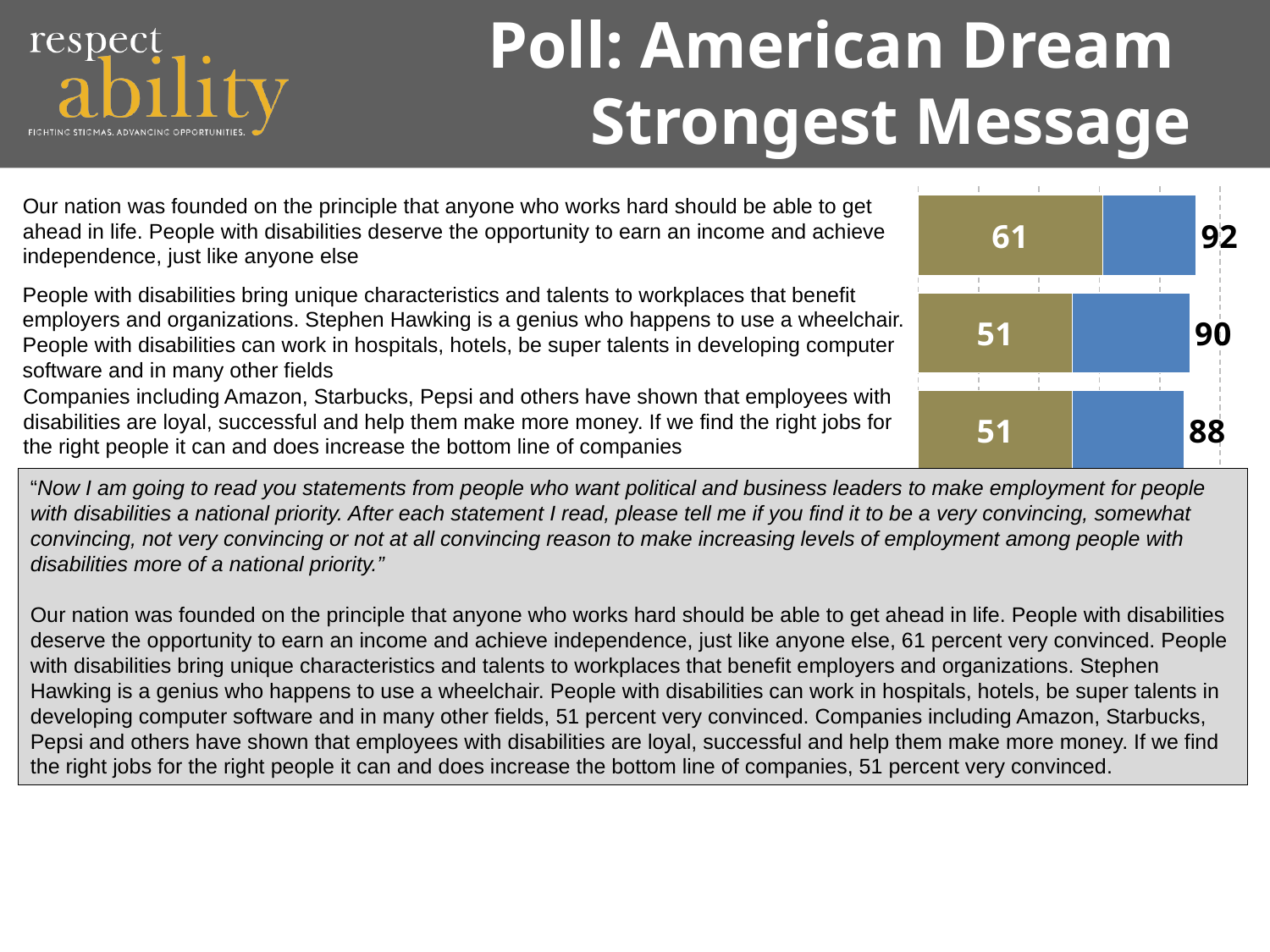
What value is printed in the olive segment of the middle bar (the Stephen Hawking statement)? 51 What value is printed in the olive segment of the top bar (the statement about the nation being founded on the principle that anyone who works hard should get ahead)? 61 What number is printed at the right end of the bottom bar (the Amazon, Starbucks, Pepsi statement)? 88 What number is printed at the right end of the top bar? 92 How many bars does the chart on the right contain? 3 Which bar has the highest value printed in its olive segment? The top bar (nation founded on the principle that anyone who works hard should get ahead) What type of chart is shown on the right side of the slide? Bar chart Do the numbers printed at the right ends of the bars increase or decrease from the top bar to the bottom bar? Decrease Which bar has the larger number at its right end: the middle bar (Stephen Hawking statement) or the bottom bar (Amazon, Starbucks, Pepsi statement)? The middle bar (Stephen Hawking statement) What is the difference between the number at the end of the top bar and the number at the end of the bottom bar? 4 What two colours are used for the segments of each bar? Olive and blue What is the difference between the olive segment value of the top bar and the olive segment value of the middle bar? 10